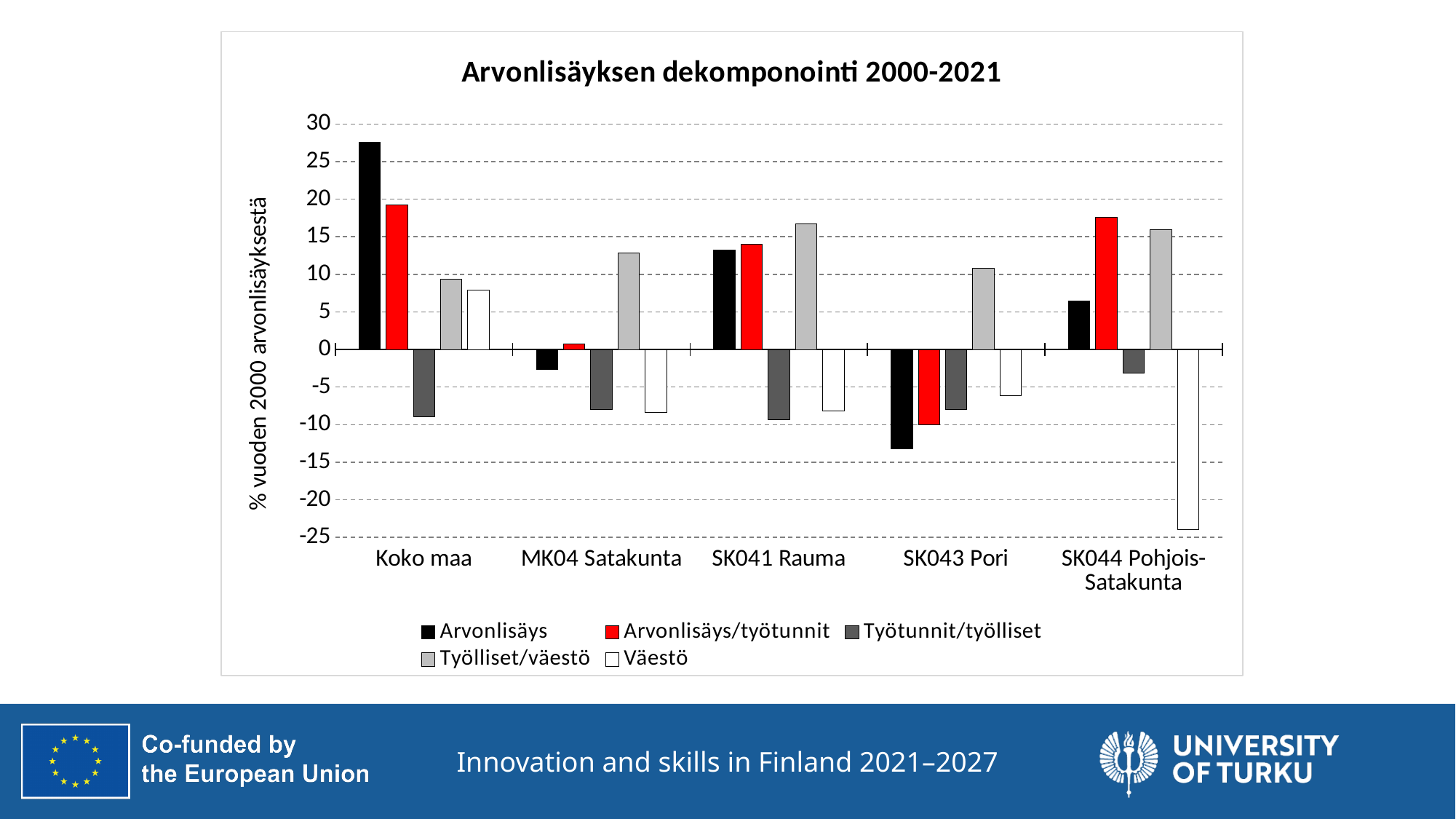
Which region has the highest Arvonlisäys value? Koko maa What kind of chart is shown on the slide? bar chart Which region has the lowest Arvonlisäys value? SK043 Pori What is the title of the chart? Arvonlisäyksen dekomponointi 2000-2021 Is the Arvonlisäys value for Koko maa greater or less than 25? greater Which region has the lowest Arvonlisäys/työtunnit value? SK043 Pori Is the Arvonlisäys value for SK043 Pori greater or less than -10? less Is the Väestö value for SK044 Pohjois-Satakunta greater or less than -20? less How many regions (categories) are shown on the x axis? 5 Which region has the lowest Väestö value? SK044 Pohjois-Satakunta Which is larger, the Työlliset/väestö value for SK041 Rauma or for Koko maa? SK041 Rauma How many series does the legend list? 5